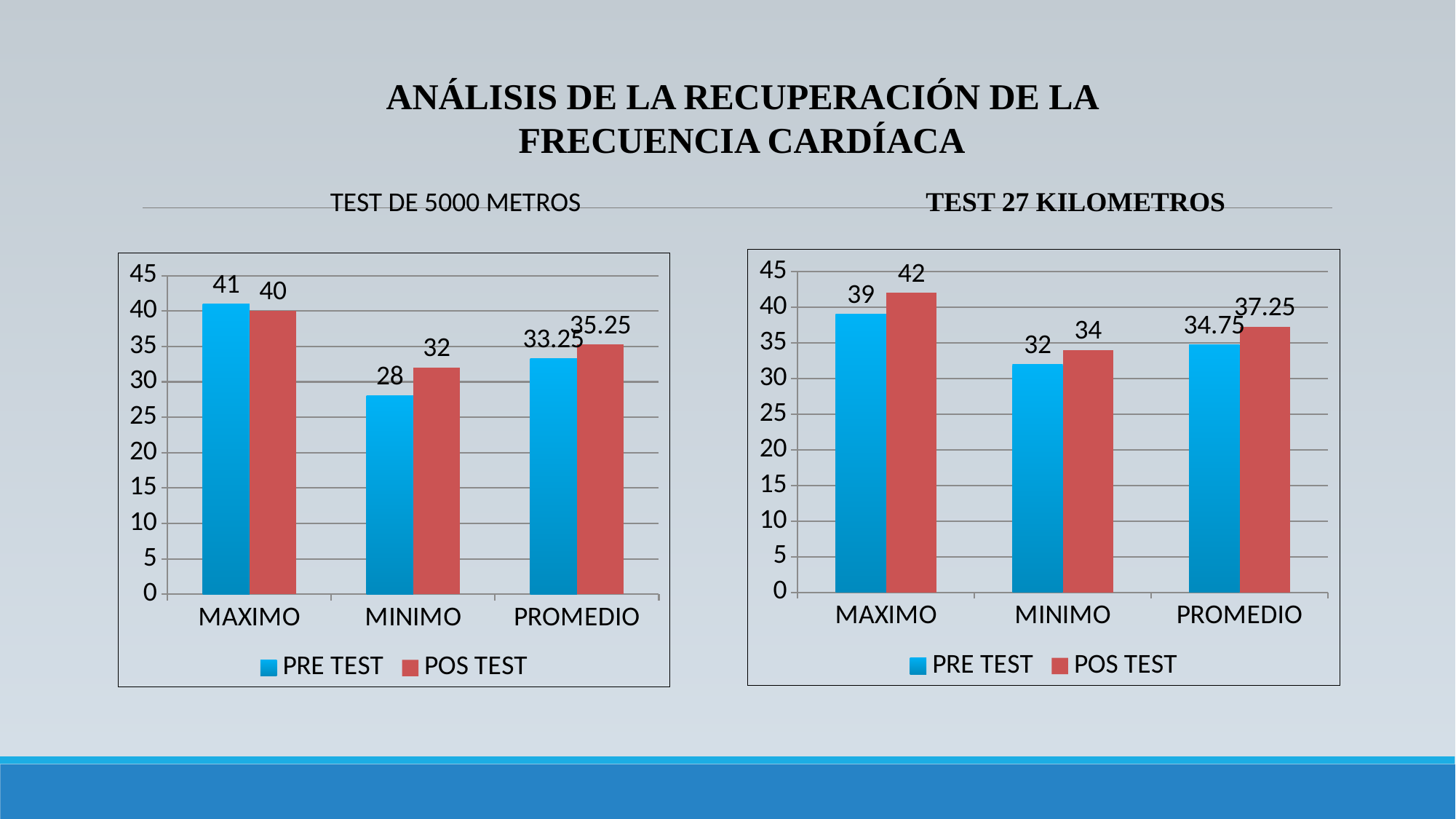
In the TEST DE 5000 METROS chart, what is the PRE TEST value for MAXIMO? 41 In the TEST DE 5000 METROS chart, which is larger for MAXIMO, the PRE TEST value or the POS TEST value? PRE TEST In the TEST 27 KILOMETROS chart, what is the POS TEST value for PROMEDIO? 37.25 In the TEST 27 KILOMETROS chart, what is the difference between the POS TEST and PRE TEST values for MAXIMO? 3 What kind of chart is the TEST 27 KILOMETROS chart? Bar chart How many series does the legend of the TEST DE 5000 METROS chart list? 2 In the TEST 27 KILOMETROS chart, what is the PRE TEST value for MINIMO? 32 In the TEST DE 5000 METROS chart, what is the difference between the POS TEST and PRE TEST values for MINIMO? 4 In the TEST DE 5000 METROS chart, what is the POS TEST value for MINIMO? 32 In the TEST 27 KILOMETROS chart, which category has the highest POS TEST value? MAXIMO In the TEST DE 5000 METROS chart, which category has the lowest PRE TEST value? MINIMO How many categories are shown on the x axis of the TEST 27 KILOMETROS chart? 3